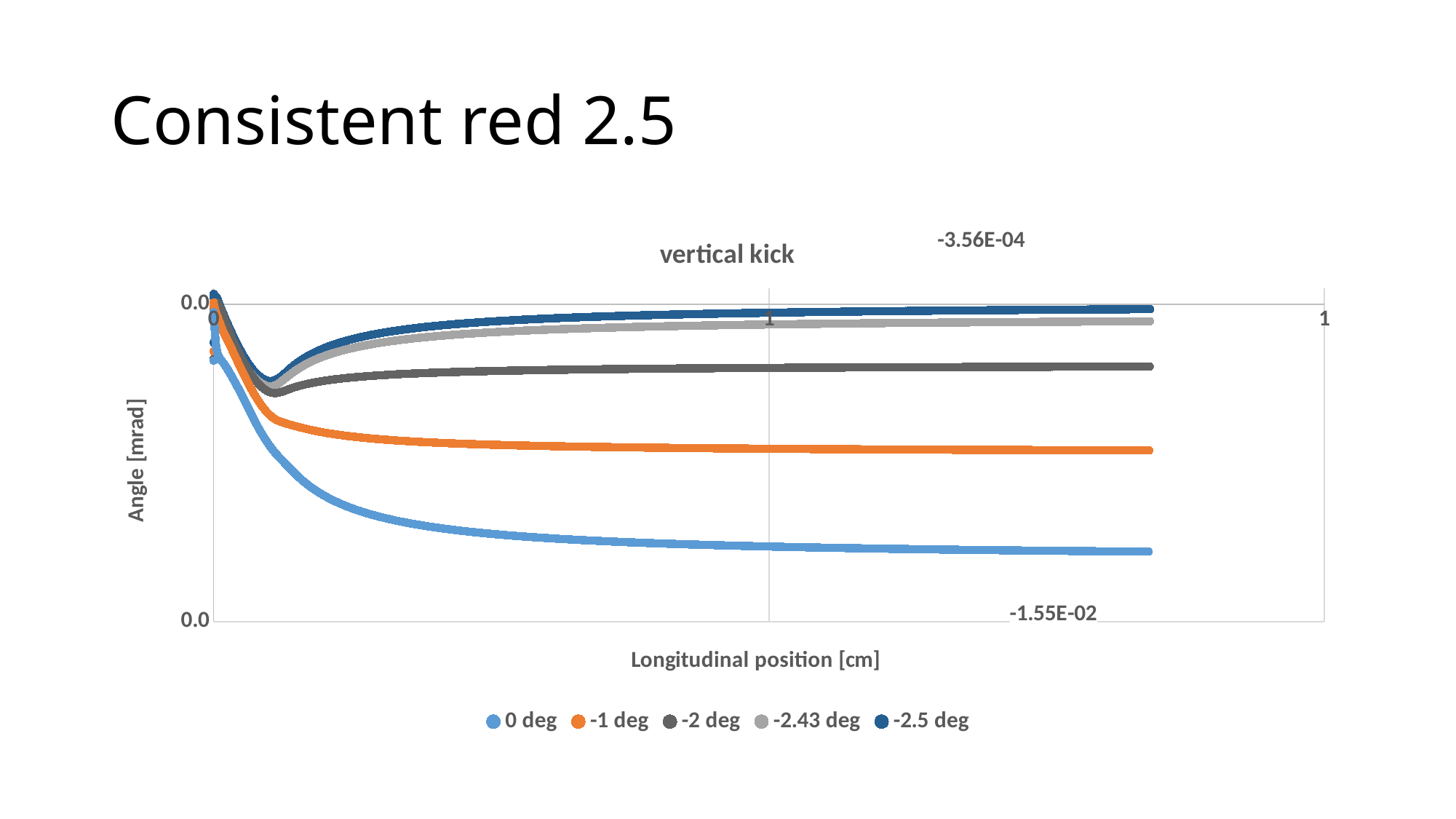
What is the title of the chart? vertical kick What is the label of the vertical axis? Angle [mrad] Does the 0 deg series rise or fall as longitudinal position increases? falls At the right end of the chart, which series has the larger angle, 0 deg or -1 deg? -1 deg Which series has the highest angle at the right end of the chart? -2.5 deg How many series does the legend list? 5 Which series has the lowest angle at the right end of the chart? 0 deg What kind of chart is shown on the slide? line chart Does the -1 deg series rise or fall as longitudinal position increases? falls At the right end of the chart, which series has the larger angle, -2 deg or -2.43 deg? -2.43 deg